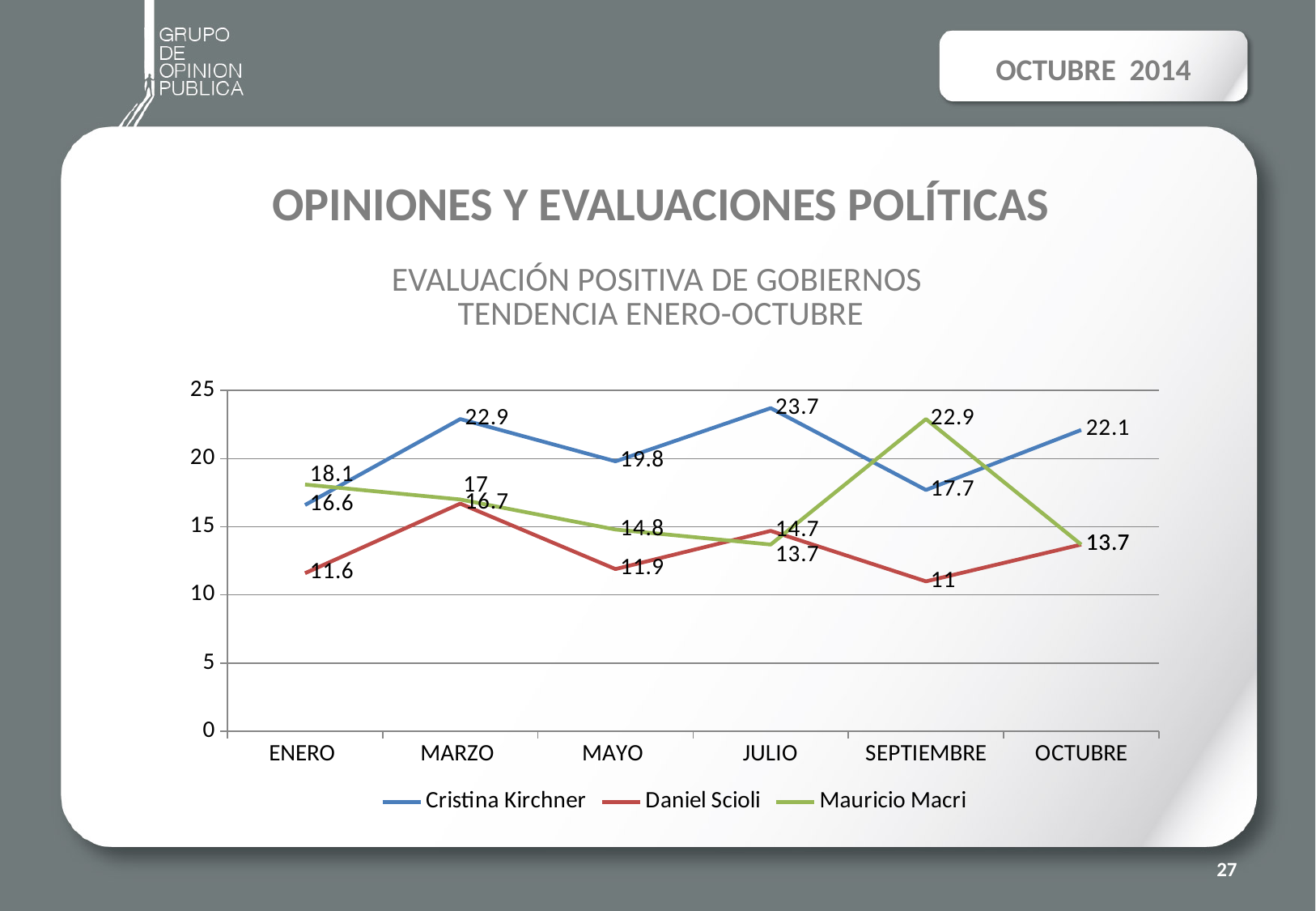
In MARZO, who has the higher value, Mauricio Macri or Daniel Scioli? Mauricio Macri In which month does Cristina Kirchner reach her highest value? JULIO How many months are shown on the x axis? 6 Is the value for Cristina Kirchner in MAYO greater or less than 20? less What kind of chart is shown on the slide? line chart In which month does Daniel Scioli have his lowest value? SEPTIEMBRE What is the value for Mauricio Macri in SEPTIEMBRE? 22.9 What is the value for Daniel Scioli in SEPTIEMBRE? 11 How many series does the legend list? 3 What is the difference between Cristina Kirchner's and Daniel Scioli's values in ENERO? 5 Does Mauricio Macri's line rise or fall from ENERO to JULIO? fall What is the value for Cristina Kirchner in JULIO? 23.7